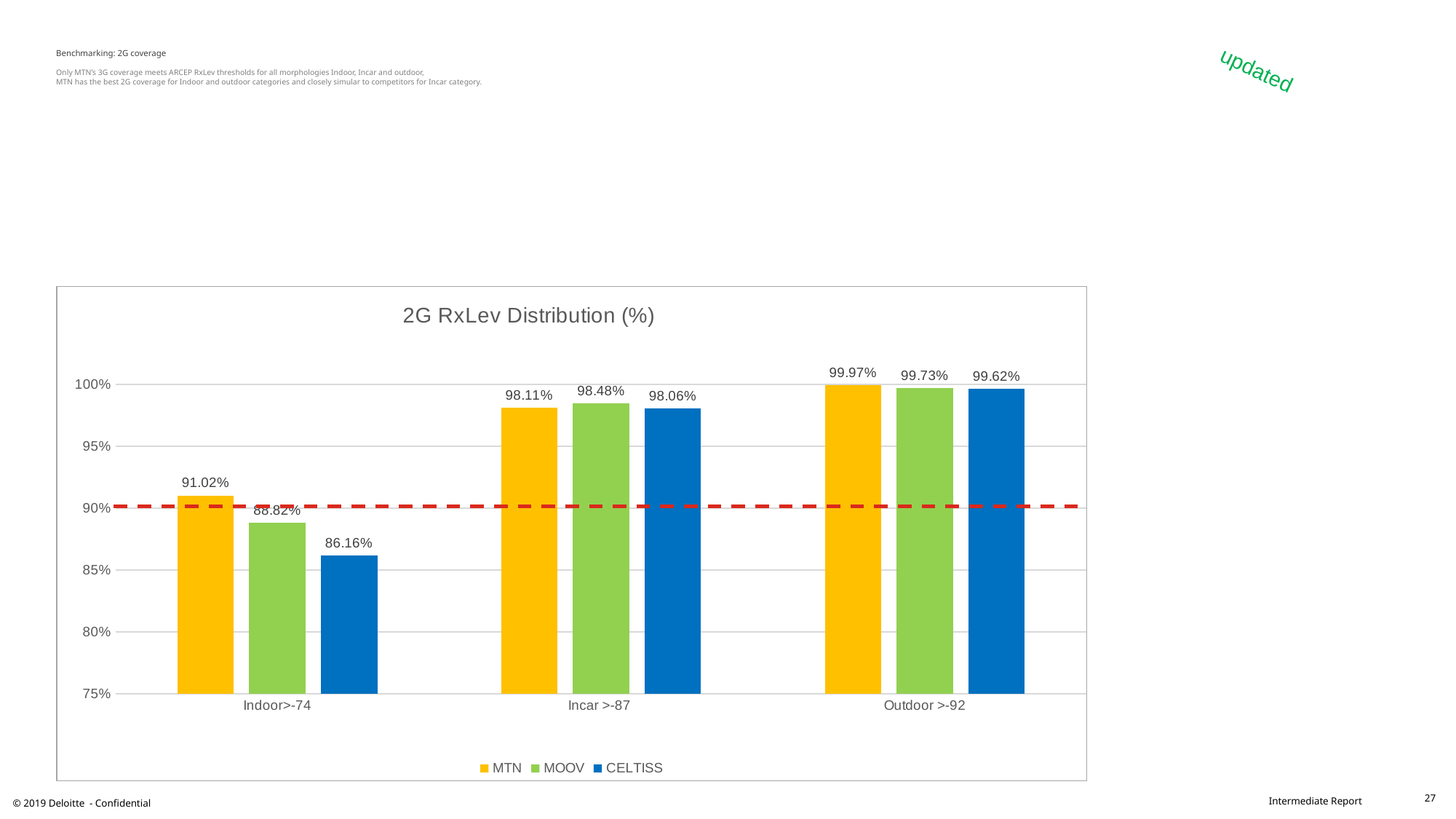
Is the value for MOOV in the Indoor>-74 category greater or less than 90%? less What is the value for MTN in the Indoor>-74 category? 91.02% Which series has the highest value in the Outdoor >-92 category? MTN What kind of chart is shown on the slide? bar chart What is the value for CELTISS in the Incar >-87 category? 98.06% How many series does the legend list? 3 Which series has the lowest value in the Indoor>-74 category? CELTISS Which is larger in the Incar >-87 category, MTN or MOOV? MOOV What is the title of the chart? 2G RxLev Distribution (%) How many categories are shown on the x axis? 3 What is the difference between the MTN and CELTISS values in the Indoor>-74 category? 4.86% What is the value for MOOV in the Outdoor >-92 category? 99.73%